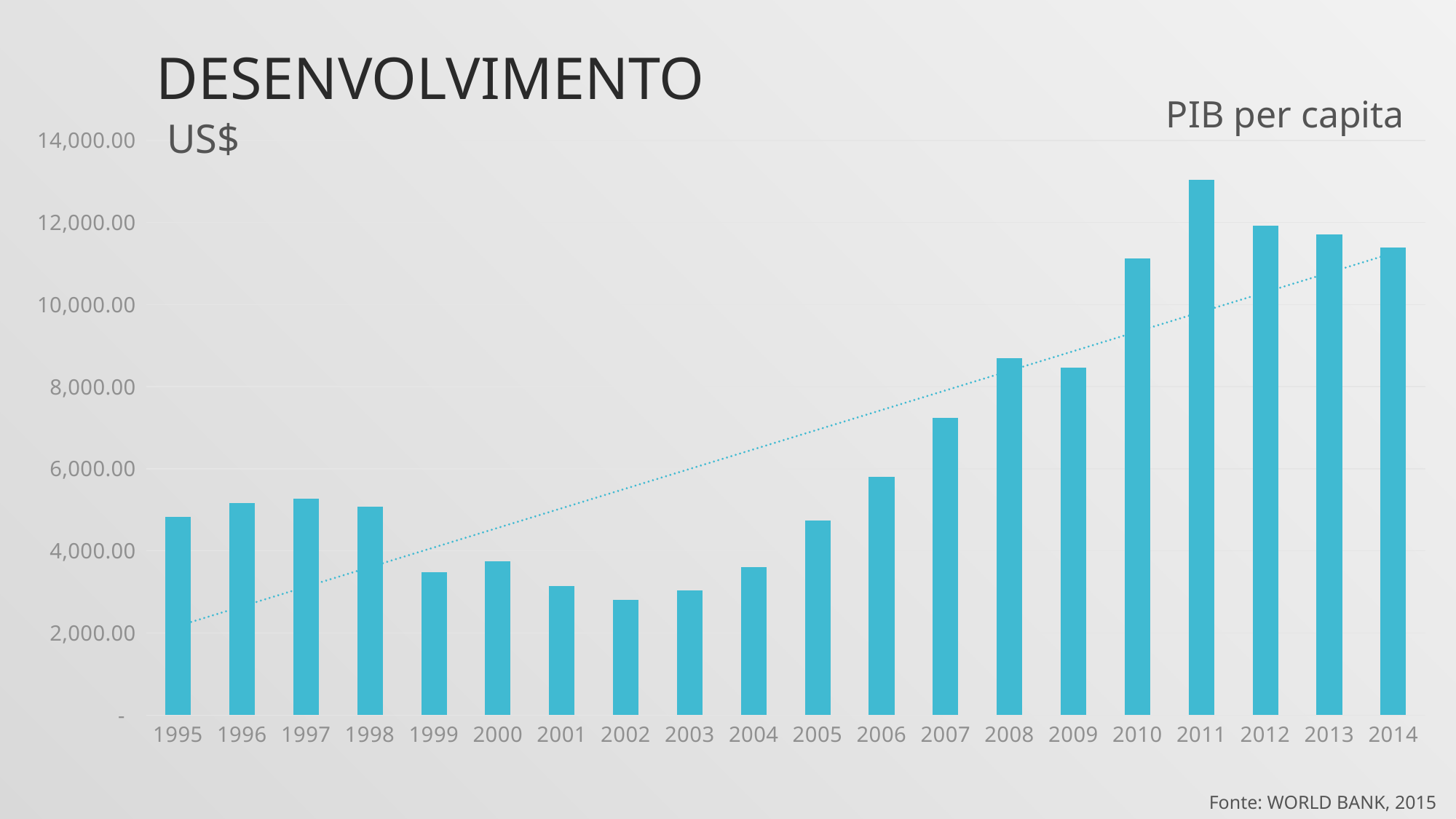
Is the value for 2010 greater or less than 10,000.00? greater Do the values rise or fall from 2003 to 2011? rise Is the value for 2002 greater or less than 4,000.00? less How many years are plotted on the x axis of the PIB per capita chart? 20 What kind of chart is shown on the slide? bar chart Which year has the highest PIB per capita? 2011 Which year has a higher PIB per capita, 2005 or 2006? 2006 Is the value for 2007 greater or less than 6,000.00? greater What source is cited for the chart data? WORLD BANK, 2015 Which year has the lowest PIB per capita? 2002 What is the title of the chart? PIB per capita